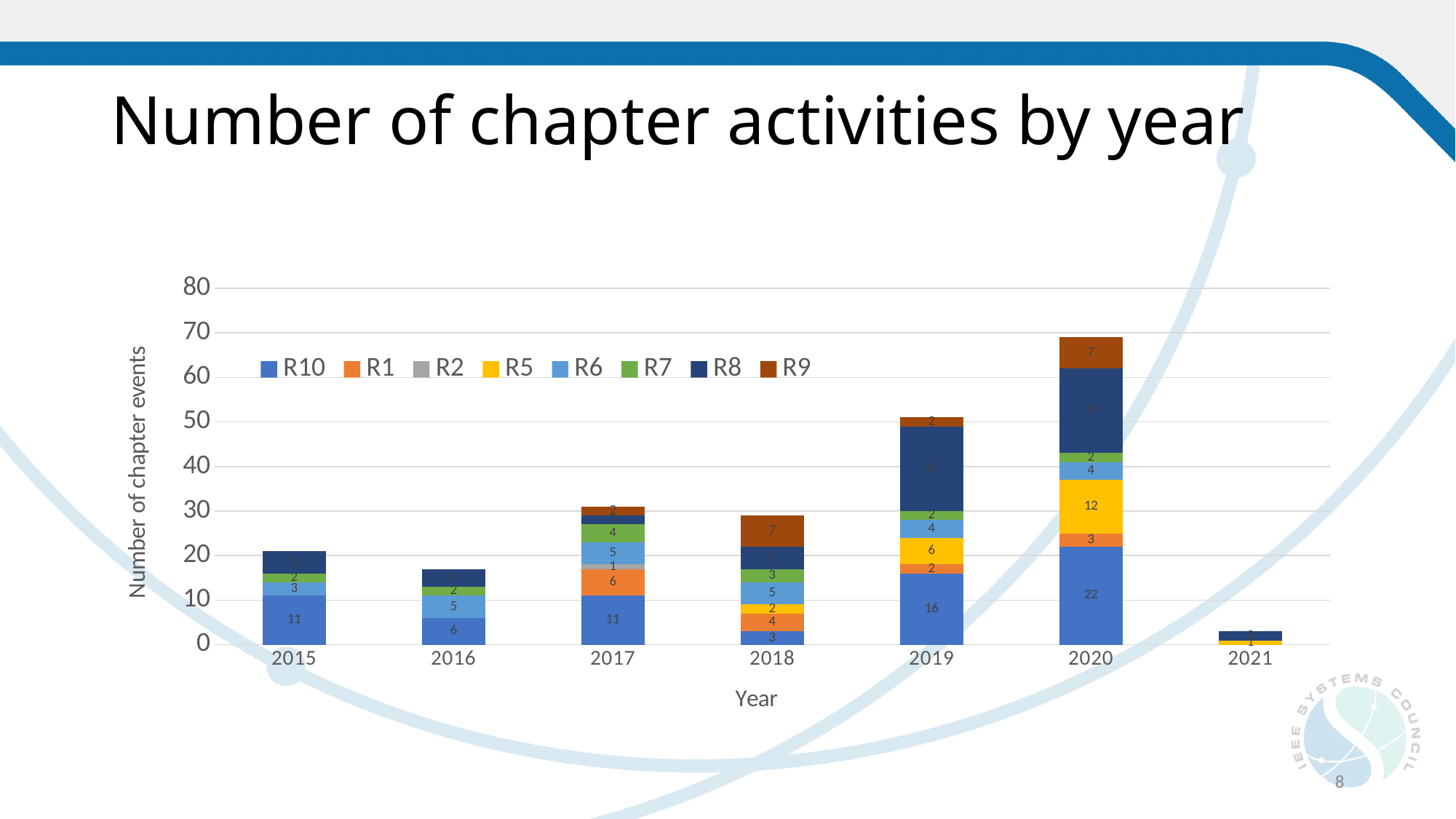
How many series does the legend list? 8 What is the R9 value for 2018? 7 What is the R5 value for 2020? 12 Which year has the shortest stacked bar? 2021 Which year has the tallest stacked bar? 2020 What is the R1 value for 2017? 6 What type of chart is shown on the slide? stacked bar chart Is the total for 2016 greater or less than 20? less What is the R10 value for 2020? 22 How many years are shown on the x axis? 7 What is the difference between the R10 value for 2020 and the R10 value for 2019? 6 Which is larger, the R10 value for 2019 or the R10 value for 2020? 2020